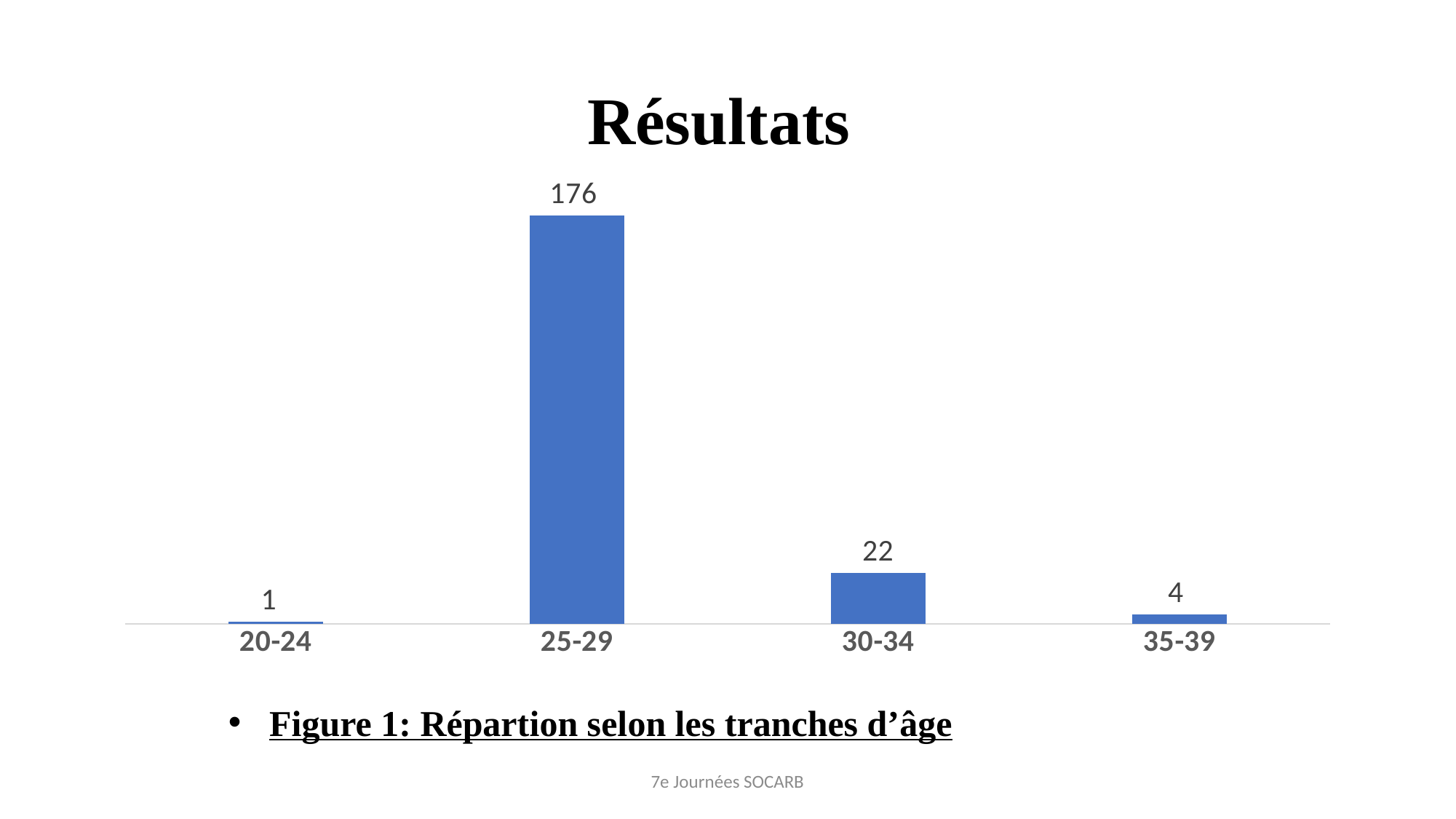
What is the difference between the values for 25-29 and 30-34? 154 What is the value for the 20-24 age group? 1 Which age group has the lowest value? 20-24 What is the difference between the values for 30-34 and 35-39? 18 What kind of chart is shown on the slide? bar chart What is the caption given for the chart on the slide? Figure 1: Répartion selon les tranches d'âge How many age groups are shown on the chart? 4 What is the value for the 35-39 age group? 4 Which age group has the highest value? 25-29 What is the value for the 25-29 age group? 176 Which is larger, the value for 30-34 or the value for 35-39? 30-34 What is the value for the 30-34 age group? 22